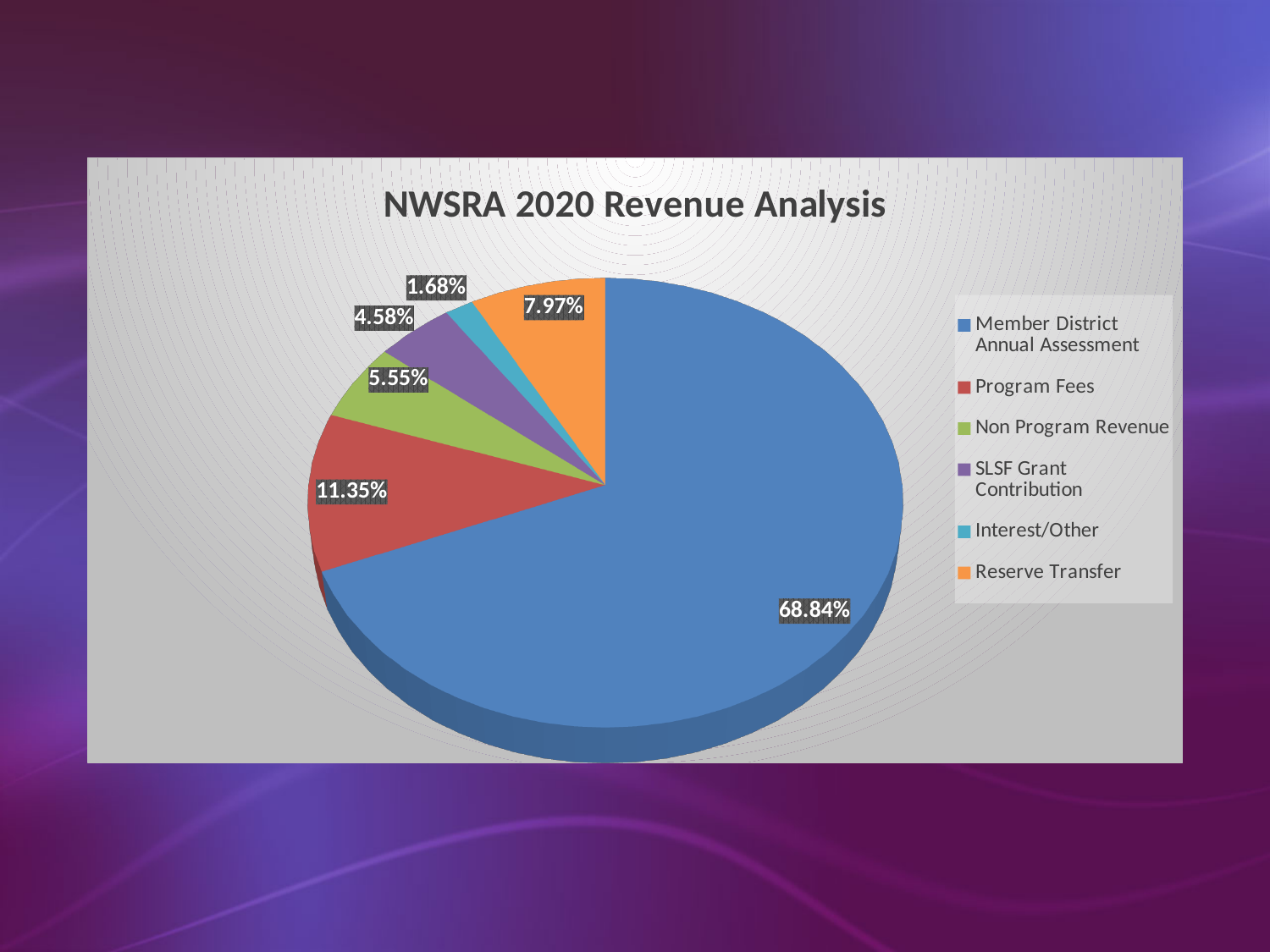
What share of revenue comes from Member District Annual Assessment? 68.84% What share of revenue comes from Reserve Transfer? 7.97% What share of revenue comes from Program Fees? 11.35% What is the title of the chart? NWSRA 2020 Revenue Analysis Which category has the largest share of the pie? Member District Annual Assessment Which category has the smallest share of the pie? Interest/Other Which is larger, the share for Reserve Transfer or the share for Non Program Revenue? Reserve Transfer How many categories does the legend list? 6 What kind of chart is shown on the slide? Pie chart